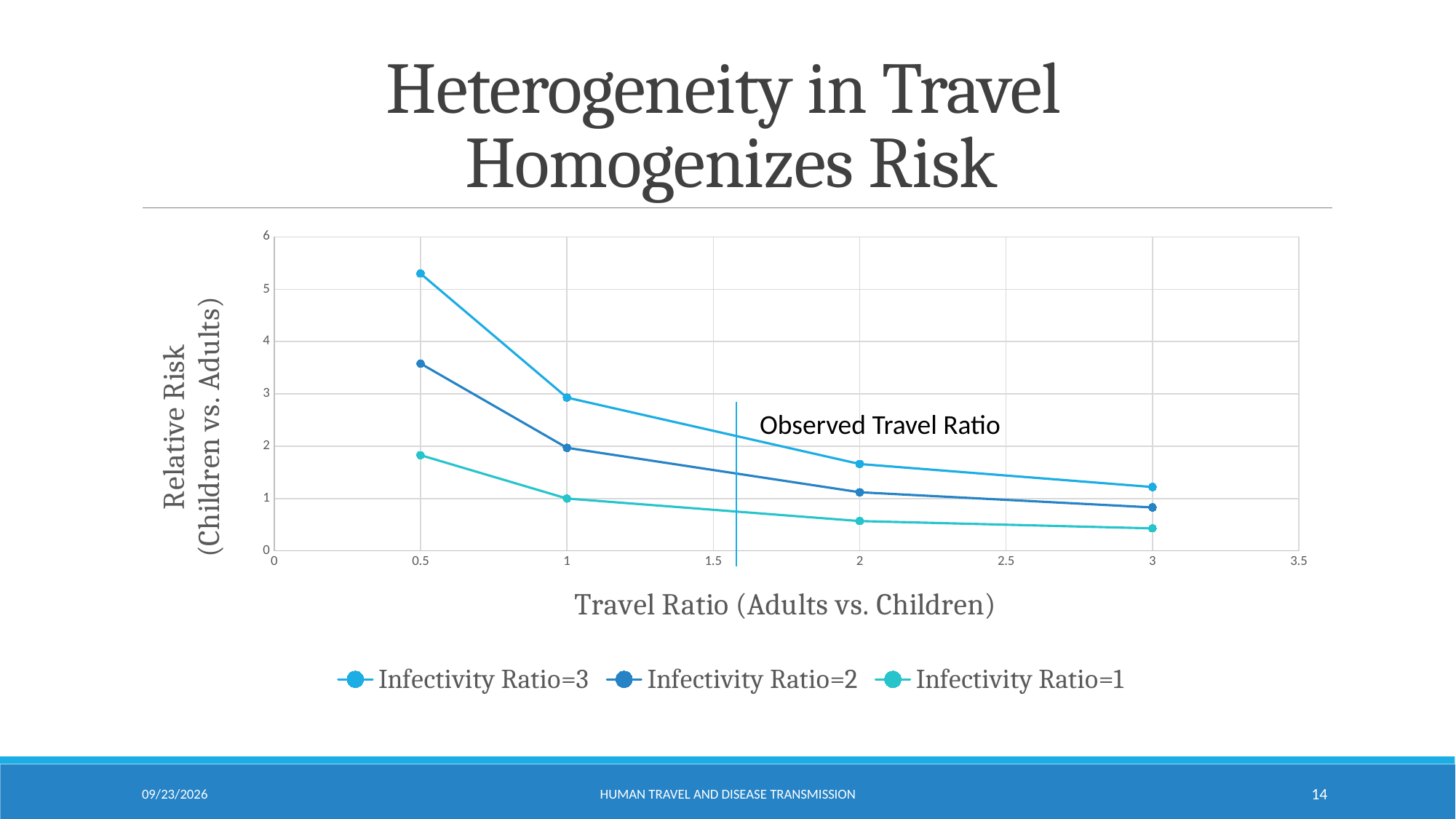
Which series has the highest relative risk at a travel ratio of 0.5? Infectivity Ratio=3 Is the relative risk for Infectivity Ratio=3 at a travel ratio of 0.5 greater or less than 5? greater How many data points are plotted for the Infectivity Ratio=3 series? 4 How many series does the legend list? 3 What kind of chart is shown on the slide? line chart Is the relative risk for Infectivity Ratio=1 at a travel ratio of 2 greater or less than 1? less Which series has the lowest relative risk at a travel ratio of 3? Infectivity Ratio=1 Is the relative risk for Infectivity Ratio=2 at a travel ratio of 0.5 greater or less than 3? greater At a travel ratio of 2, which is larger: the relative risk for Infectivity Ratio=3 or for Infectivity Ratio=1? Infectivity Ratio=3 Does the relative risk for Infectivity Ratio=2 rise or fall as the travel ratio increases? fall What is the label of the vertical line annotation on the chart? Observed Travel Ratio What is the title of the x axis? Travel Ratio (Adults vs. Children)